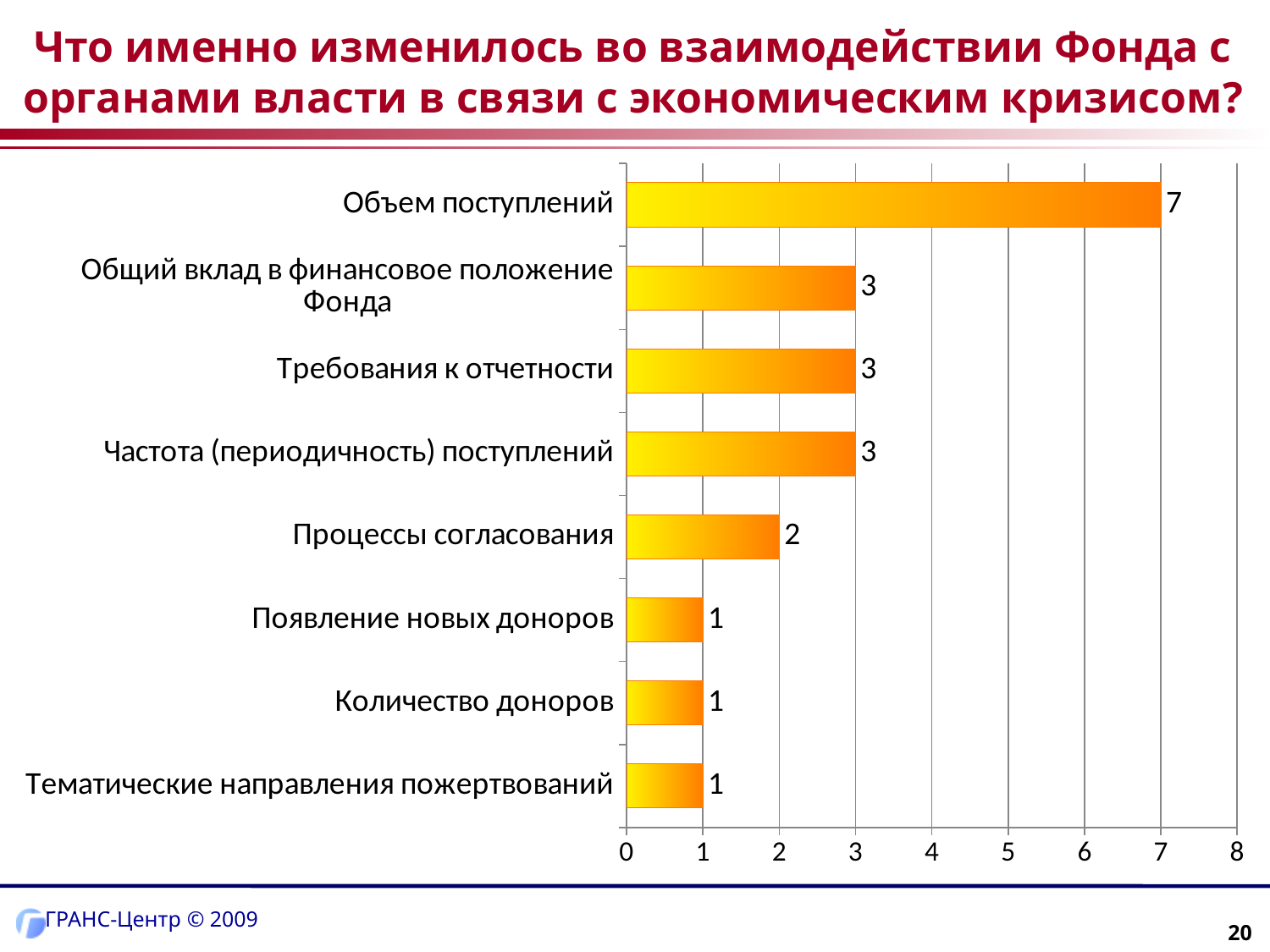
What is the value for Объем поступлений? 7 Which is larger, the value for Частота (периодичность) поступлений or the value for Процессы согласования? Частота (периодичность) поступлений What is the value for Процессы согласования? 2 How many categories have a value of 3? 3 What is the difference between the values for Процессы согласования and Появление новых доноров? 1 How many categories are shown in the chart? 8 What kind of chart is shown on the slide? bar chart What is the value for Количество доноров? 1 Which category has the highest value? Объем поступлений What is the value for Требования к отчетности? 3 What is the difference between the values for Объем поступлений and Общий вклад в финансовое положение Фонда? 4 Is the value for Объем поступлений greater or less than 5? greater